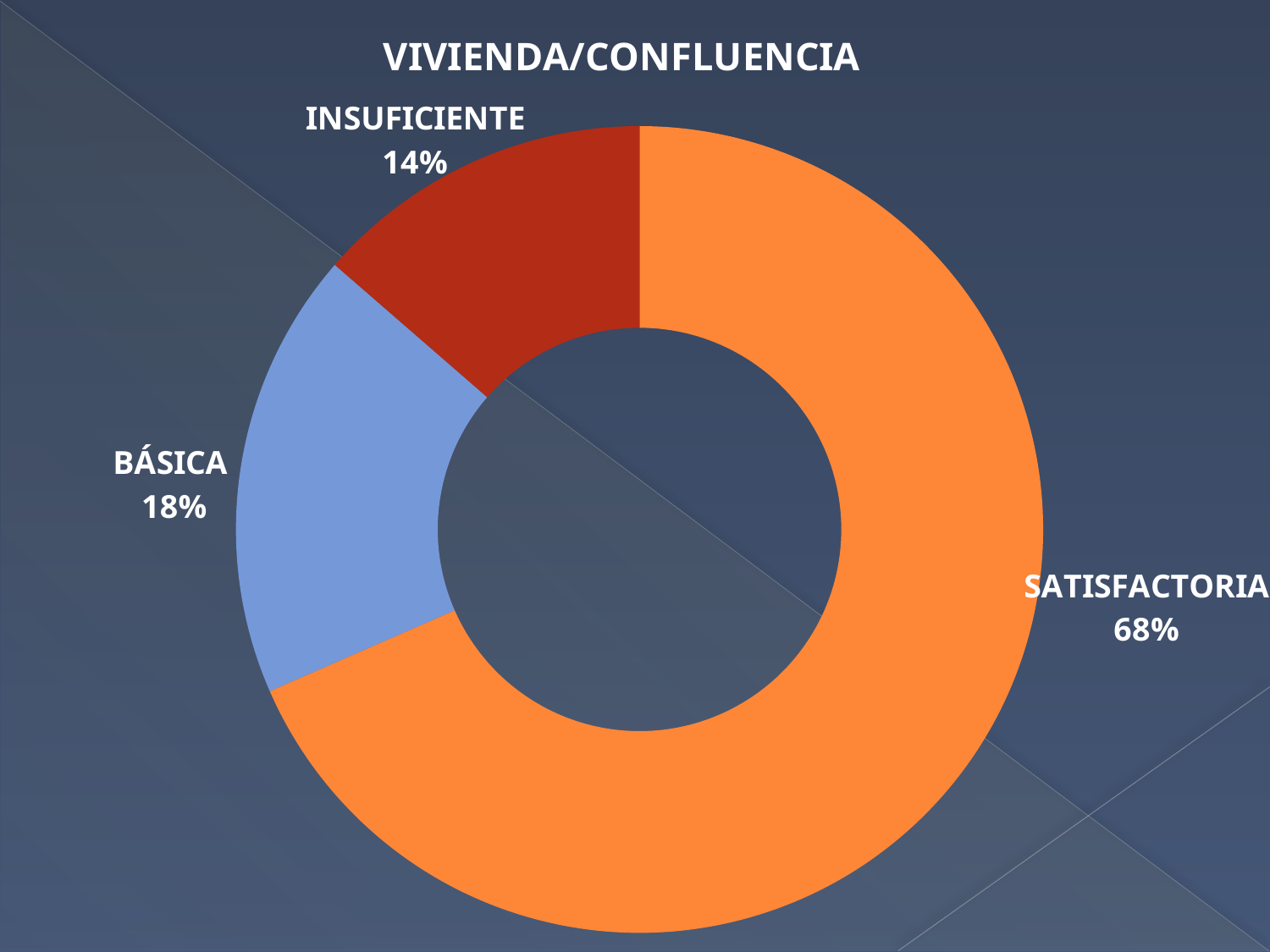
What is the title of the chart? VIVIENDA/CONFLUENCIA Which category has the largest share? SATISFACTORIA Which category has the smallest share? INSUFICIENTE What share does SATISFACTORIA have? 68% What share does INSUFICIENTE have? 14% What share does BÁSICA have? 18% Which is larger, the share of BÁSICA or the share of INSUFICIENTE? BÁSICA What is the difference between the shares of BÁSICA and INSUFICIENTE? 4% How many categories are shown in the chart? 3 What is the difference between the shares of SATISFACTORIA and BÁSICA? 50% What kind of chart is shown on the slide? Doughnut (pie) chart What colour is the SATISFACTORIA slice? Orange